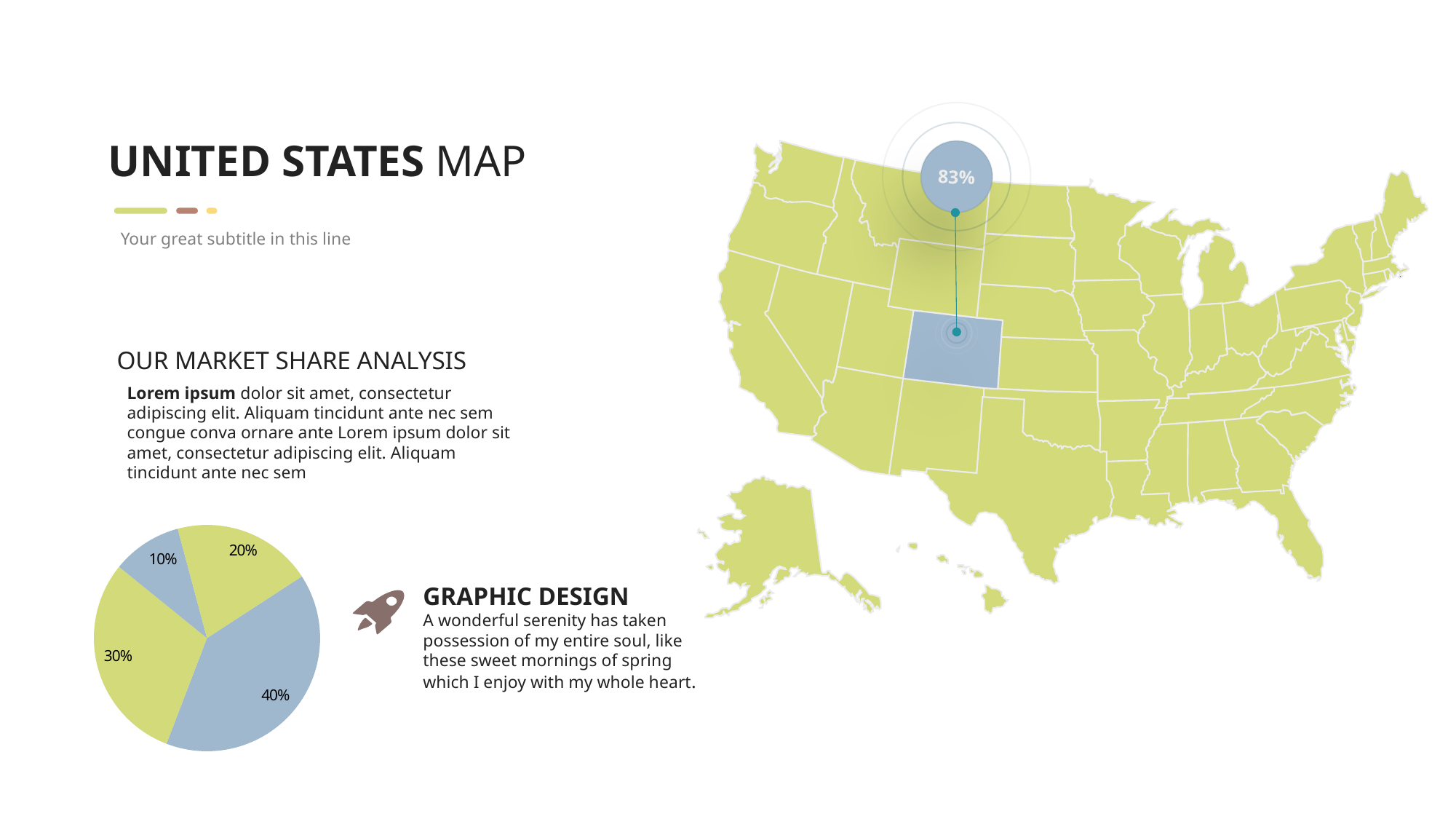
What is the difference between the 30% slice and the 20% slice of the pie chart? 10% What is the smallest value shown in the pie chart? 10% What value is shown on the blue slice at the top left of the pie chart? 10% What is the largest value shown in the pie chart? 40% What value is shown on the large blue slice on the right side of the pie chart? 40% How many slices does the pie chart have? 4 What do the four slice values of the pie chart add up to? 100% What is the difference between the largest and smallest slices of the pie chart? 30% How many slices of the pie chart are coloured blue? 2 What kind of chart is shown at the bottom left of the slide? pie chart In the pie chart, which is larger: the slice labelled 30% or the slice labelled 20%? 30% What percentage is shown in the callout circle above the highlighted state on the map? 83%